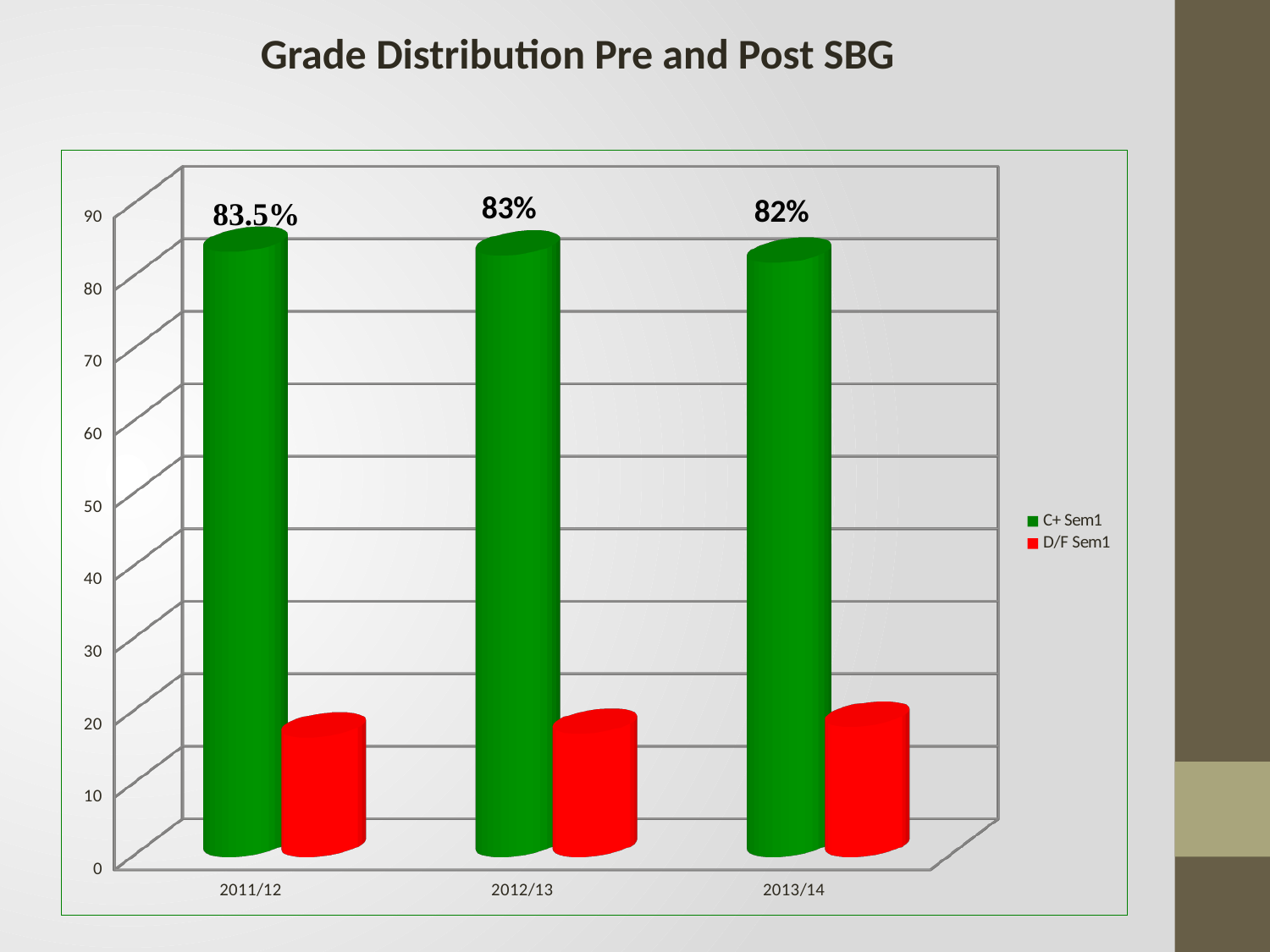
Which year has the highest C+ Sem1 value? 2011/12 How many years are shown on the x axis? 3 How many series does the legend list? 2 Is the value for D/F Sem1 in 2011/12 greater or less than 30? less What is the value for C+ Sem1 in 2012/13? 83% What is the value for C+ Sem1 in 2011/12? 83.5% Do the C+ Sem1 values rise or fall from 2011/12 to 2013/14? fall Is the value for D/F Sem1 in 2013/14 greater or less than 10? greater What is the difference between the C+ Sem1 values for 2011/12 and 2013/14? 1.5% Which year has the lowest C+ Sem1 value? 2013/14 What is the value for C+ Sem1 in 2013/14? 82% Which is larger, the C+ Sem1 value for 2012/13 or for 2013/14? 2012/13